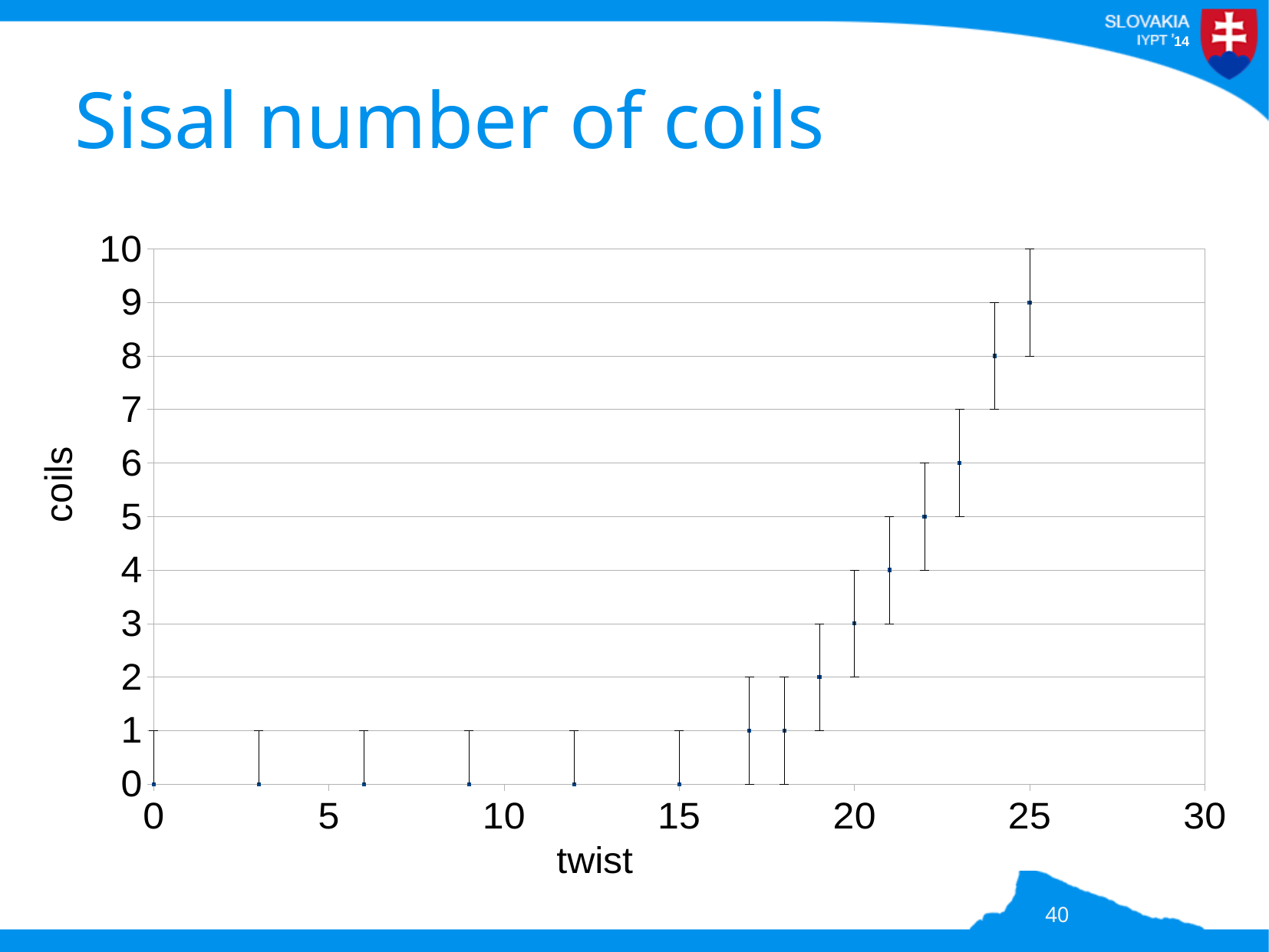
At which twist value is the number of coils highest? 25 How many coils are plotted at a twist of 15? 0 Do the number of coils generally rise or fall as twist increases? rise What are the labels of the x axis and y axis? twist (x axis), coils (y axis) Which has more coils, twist 22 or twist 19? twist 22 How many coils are plotted at a twist of 20? 3 What kind of chart is shown on the slide? scatter plot How many coils are plotted at a twist of 24? 8 What is the difference in coils between twist 25 and twist 20? 6 How many data points are plotted on the chart? 15 How many coils are plotted at a twist of 25? 9 What is the title of the chart? Sisal number of coils